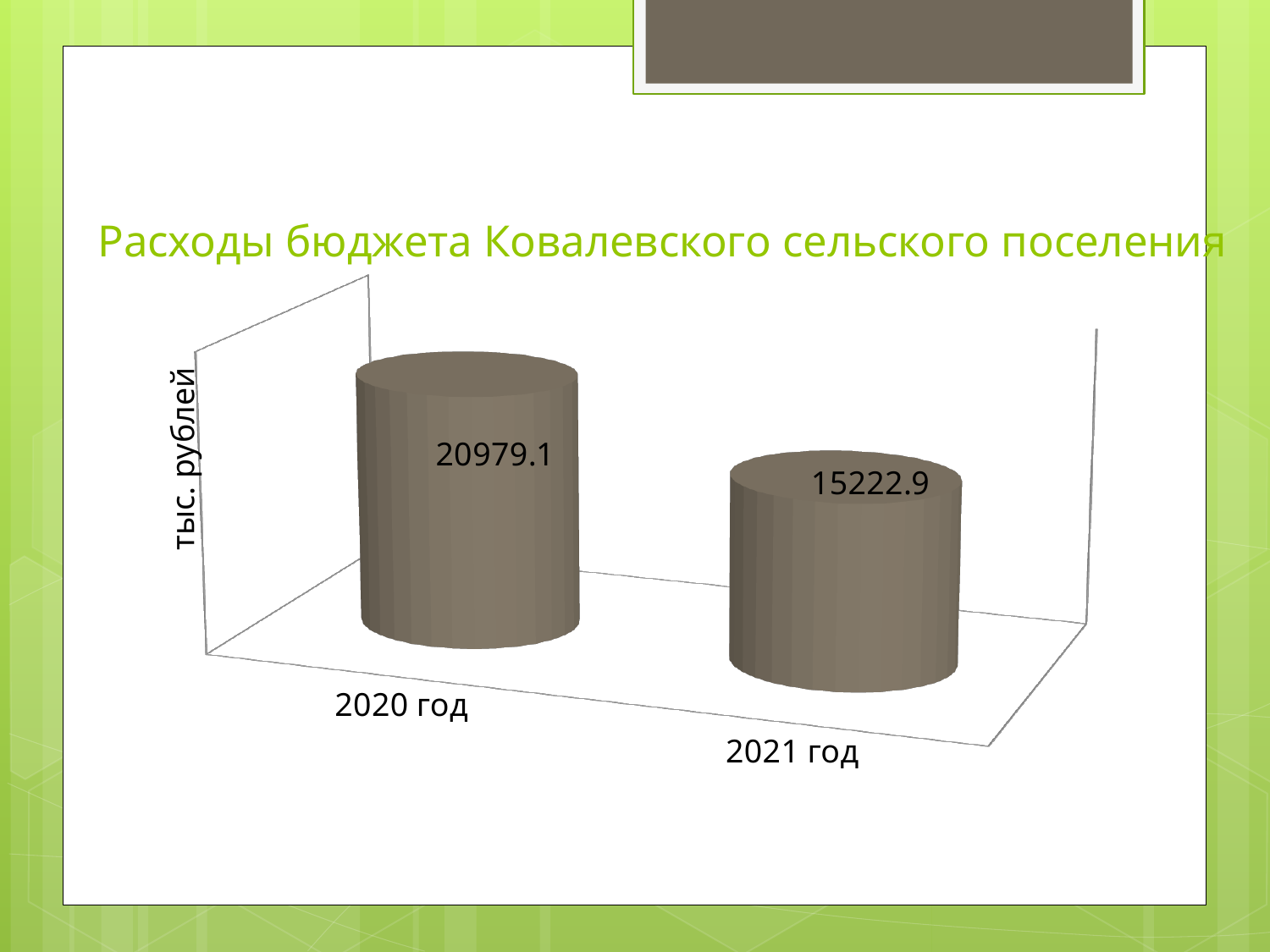
How many categories are shown on the chart? 2 What is the label of the vertical axis? тыс. рублей What is the value for 2020 год? 20979.1 Do the values rise or fall from 2020 год to 2021 год? fall What is the title of the chart? Расходы бюджета Ковалевского сельского поселения Which year has the highest value? 2020 год Which year has the lowest value? 2021 год What is the difference between the values for 2020 год and 2021 год? 5756.2 What is the value for 2021 год? 15222.9 What kind of chart is shown on the slide? bar chart Which is larger, the value for 2020 год or the value for 2021 год? 2020 год